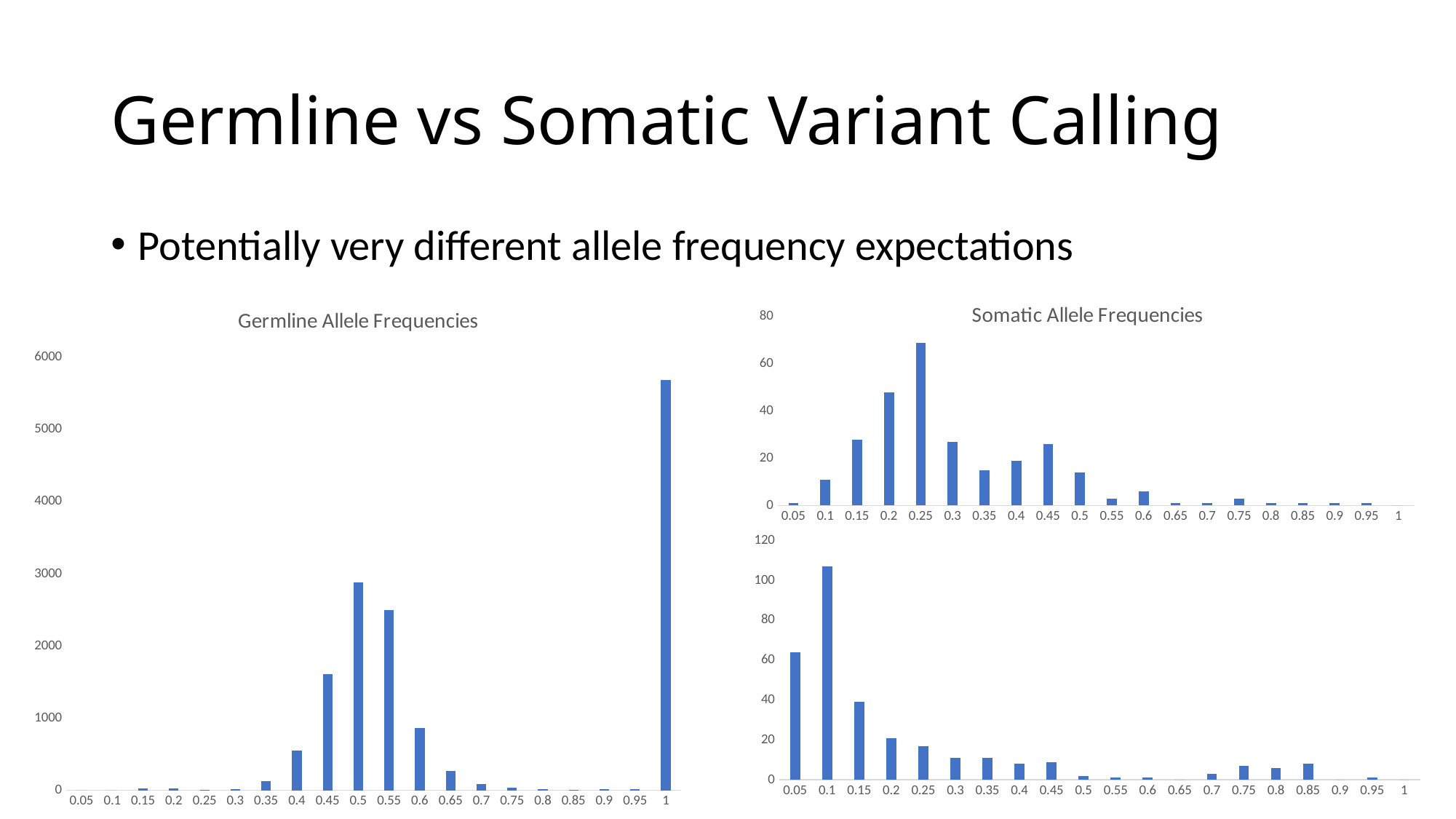
In the untitled chart at the bottom right, is the value for 0.1 greater or less than 100? greater In the Germline Allele Frequencies chart, is the value for 0.5 greater or less than 2000? greater In the Germline Allele Frequencies chart, is the value for 0.45 greater or less than 2000? less What type of chart is the Germline Allele Frequencies chart? bar chart How many allele frequency categories are shown on the x axis of the Germline Allele Frequencies chart? 20 In the untitled chart at the bottom right, which allele frequency category has the highest bar? 0.1 In the Somatic Allele Frequencies chart (top right), which is larger, the value for 0.2 or the value for 0.3? 0.2 In the Somatic Allele Frequencies chart (top right), which allele frequency category has the highest bar? 0.25 In the Germline Allele Frequencies chart, which allele frequency category has the highest bar? 1 In the Germline Allele Frequencies chart, which is larger, the value for 0.5 or the value for 0.6? 0.5